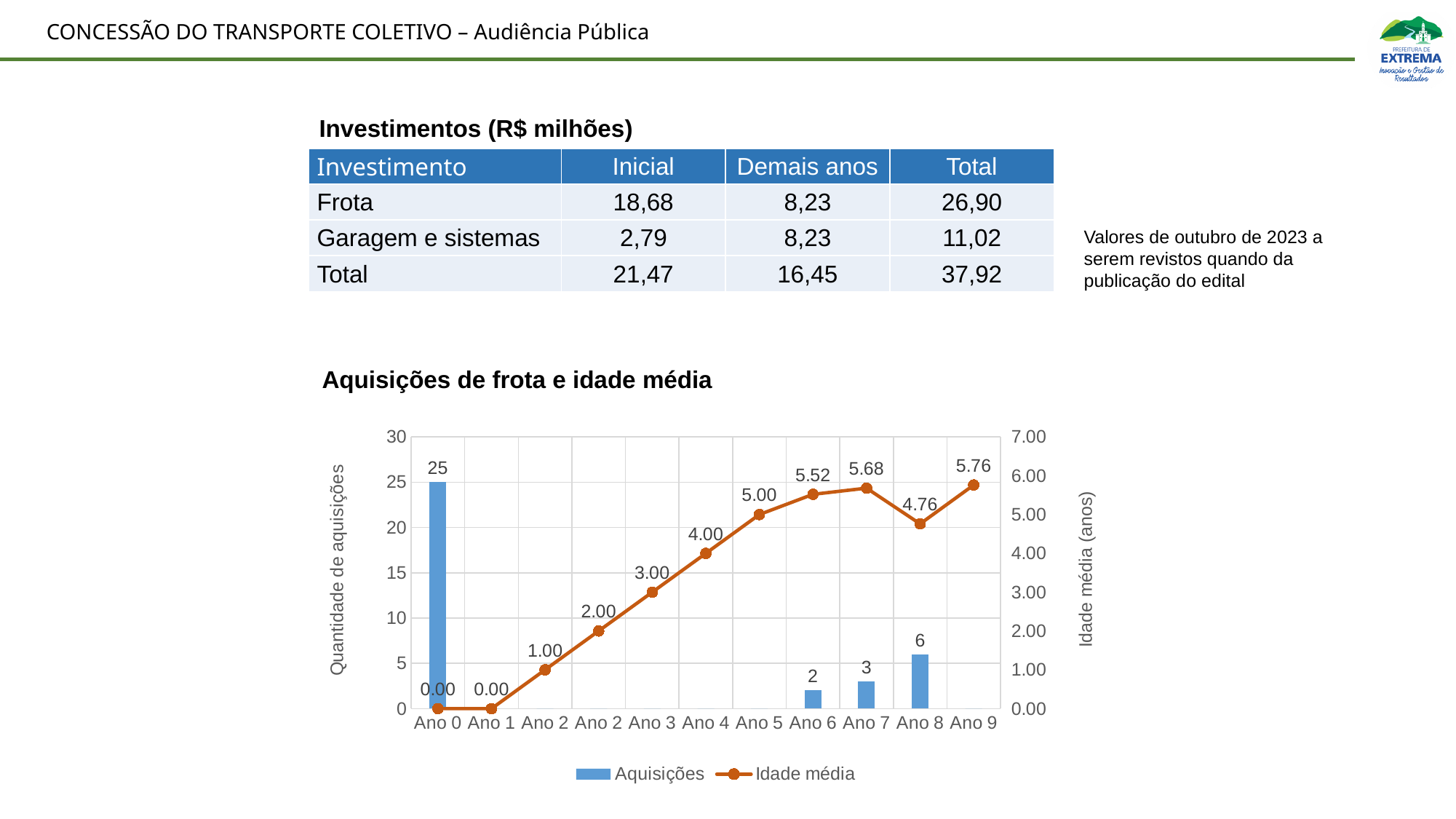
In the chart 'Aquisições de frota e idade média', which year has the highest number of Aquisições? Ano 0 In the chart 'Aquisições de frota e idade média', which year has the highest Idade média? Ano 9 In the chart 'Aquisições de frota e idade média', which has more Aquisições, Ano 6 or Ano 7? Ano 7 In the chart 'Aquisições de frota e idade média', what is the Idade média for Ano 5? 5.00 How many categories are shown on the x axis of the chart 'Aquisições de frota e idade média'? 11 What kind of chart is 'Aquisições de frota e idade média'? Combined bar and line chart How many series does the legend of the chart 'Aquisições de frota e idade média' list? 2 In the chart 'Aquisições de frota e idade média', what is the Idade média for Ano 7? 5.68 In the chart 'Aquisições de frota e idade média', what is the difference in Aquisições between Ano 0 and Ano 8? 19 In the chart 'Aquisições de frota e idade média', what is the value of Aquisições for Ano 0? 25 In the chart 'Aquisições de frota e idade média', how many Aquisições are shown for Ano 8? 6 In the chart 'Aquisições de frota e idade média', what is the difference between the Idade média for Ano 9 and Ano 8? 1.00